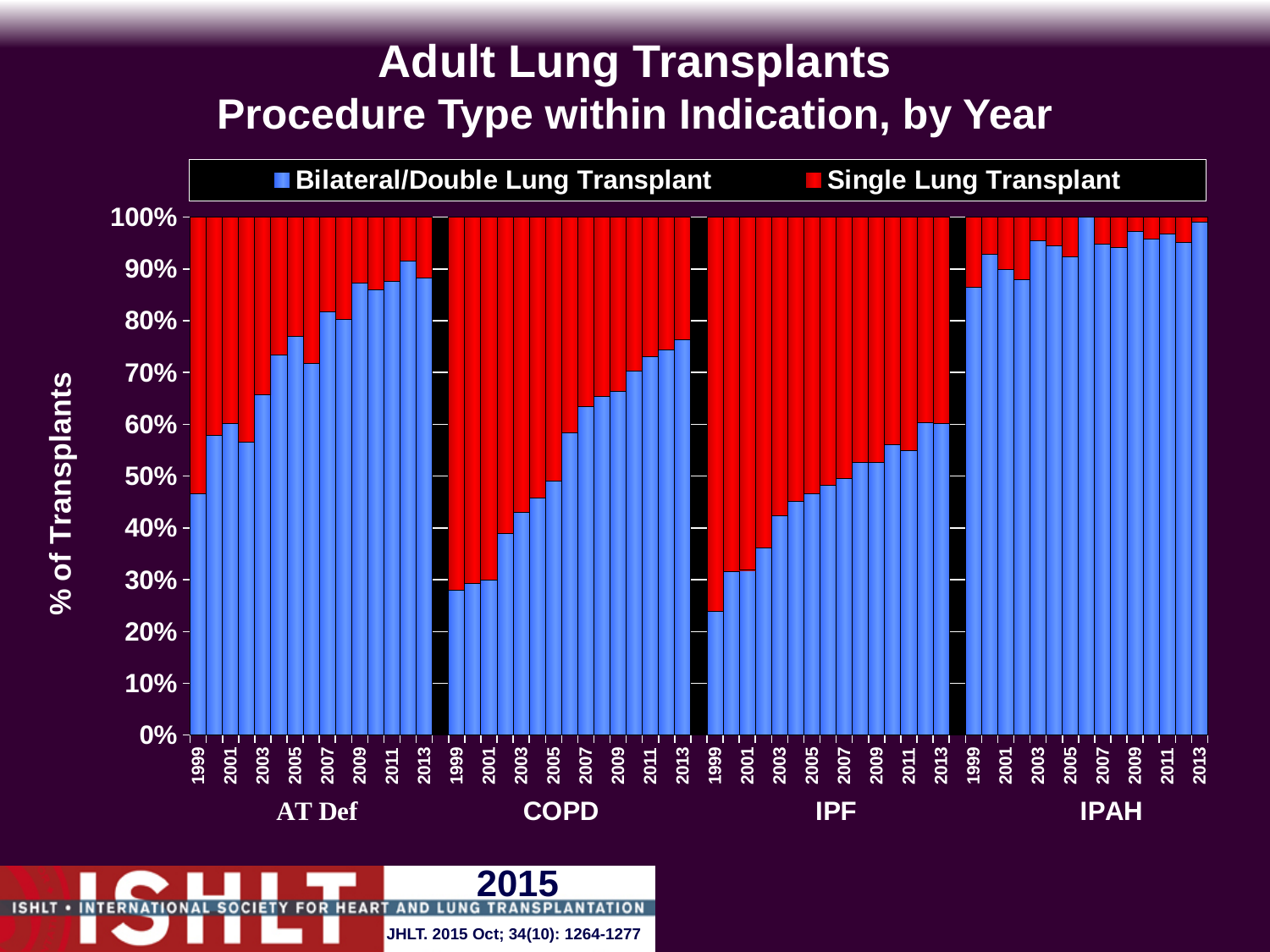
Which colour represents Single Lung Transplant in the chart? Red How many years are plotted within each indication group? 15 What kind of chart is shown on the slide? Stacked bar chart Within the COPD group, does the Bilateral/Double Lung Transplant share rise or fall from 1999 to 2013? rise Is the Bilateral/Double Lung Transplant share for AT Def in 1999 greater or less than 50%? less Is the Bilateral/Double Lung Transplant share for IPF in 1999 greater or less than 30%? less In 1999, which has the larger Bilateral/Double Lung Transplant share, AT Def or COPD? AT Def How many indication groups are shown along the x axis? 4 Is the Bilateral/Double Lung Transplant share for COPD in 2013 greater or less than 70%? greater Which indication group has the highest Bilateral/Double Lung Transplant share in 1999? IPAH How many series does the legend list? 2